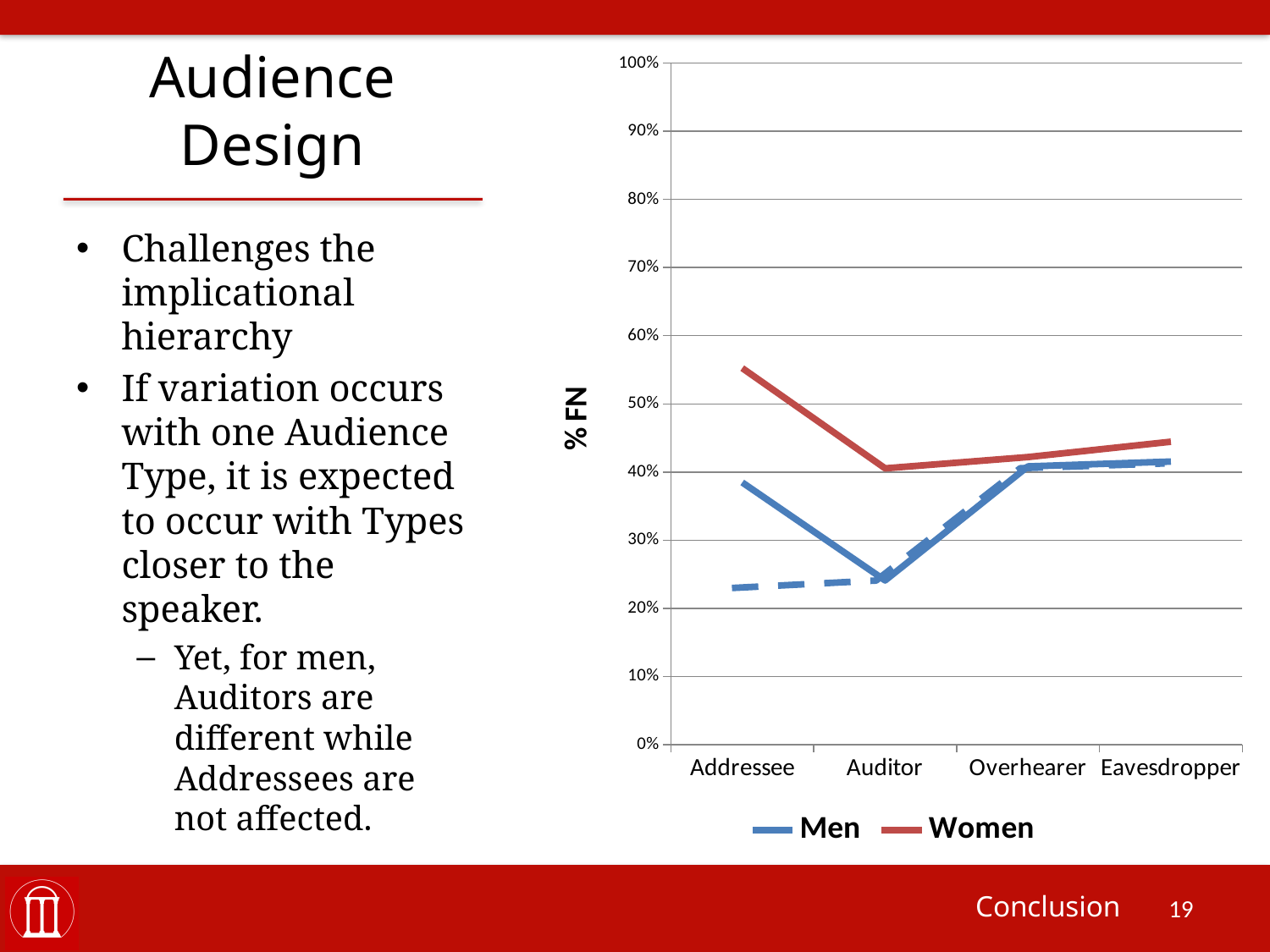
What is the label on the y axis of the chart? % FN What kind of chart is shown on the slide? line chart Is the value for Men at Auditor greater or less than 30%? less How many audience types are shown on the x axis of the chart? 4 At Addressee, which series has the higher value, Men or Women? Women At which audience type is the Men series lowest? Auditor Is the value for Women at Addressee greater or less than 50%? greater Is the value for Men at Eavesdropper greater or less than 50%? less How many series does the chart legend list? 2 Does the Men series rise or fall from Addressee to Auditor? fall At which audience type is the Women series highest? Addressee